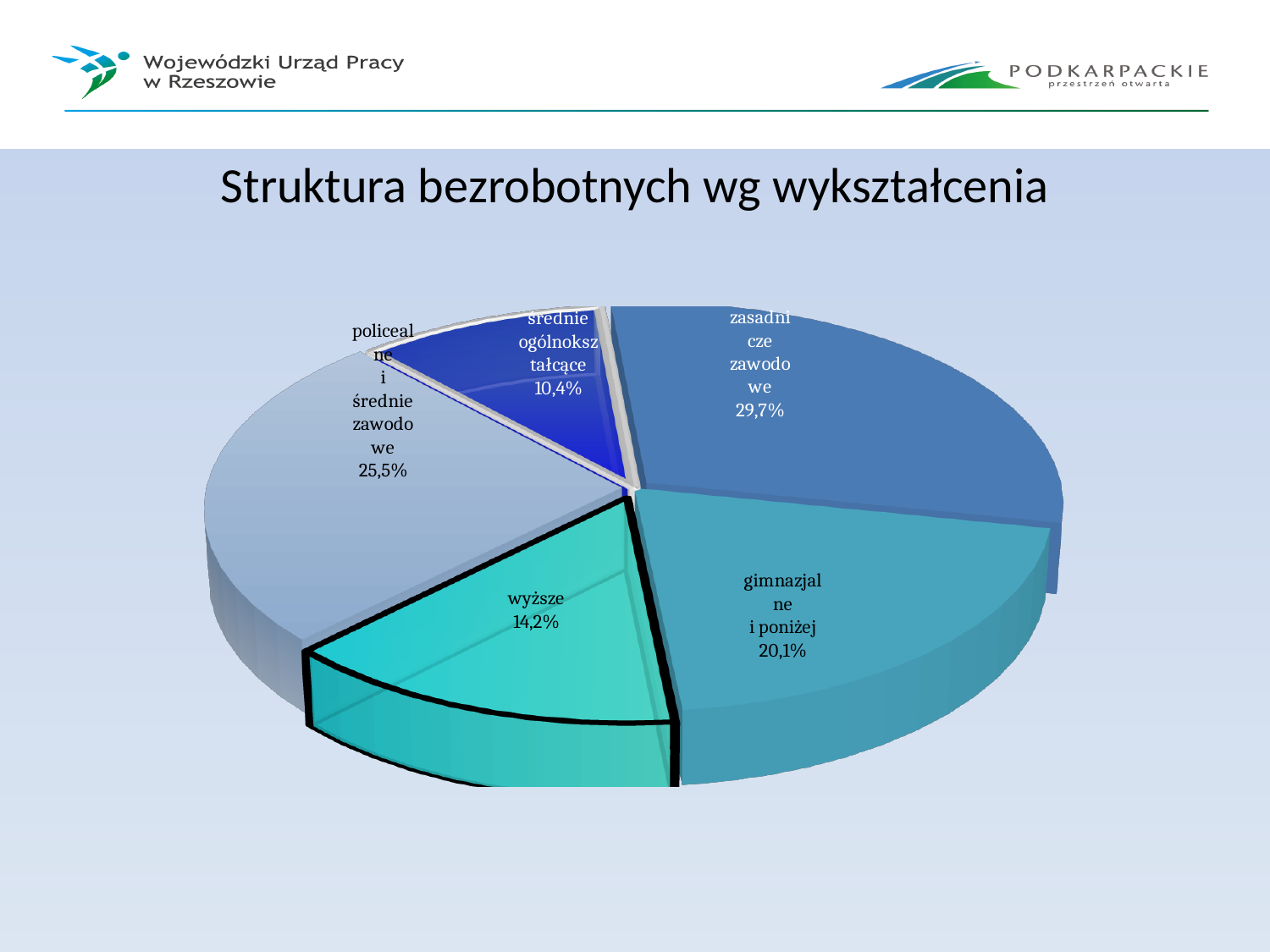
What is the difference in percentage points between the "zasadnicze zawodowe" share and the "wyższe" share? 15,5 What share of the pie is labelled "zasadnicze zawodowe"? 29,7% Which category has the largest share of the pie? zasadnicze zawodowe What share of the pie is labelled "policealne i średnie zawodowe"? 25,5% What share of the pie is labelled "wyższe"? 14,2% What is the title of the chart? Struktura bezrobotnych wg wykształcenia What share of the pie is labelled "gimnazjalne i poniżej"? 20,1% How many slices does the pie chart have? 5 Which category has the smallest share of the pie? średnie ogólnokształcące What share of the pie is labelled "średnie ogólnokształcące"? 10,4% What kind of chart is shown on the slide? pie chart Which is larger: the share for "policealne i średnie zawodowe" or the share for "gimnazjalne i poniżej"? policealne i średnie zawodowe